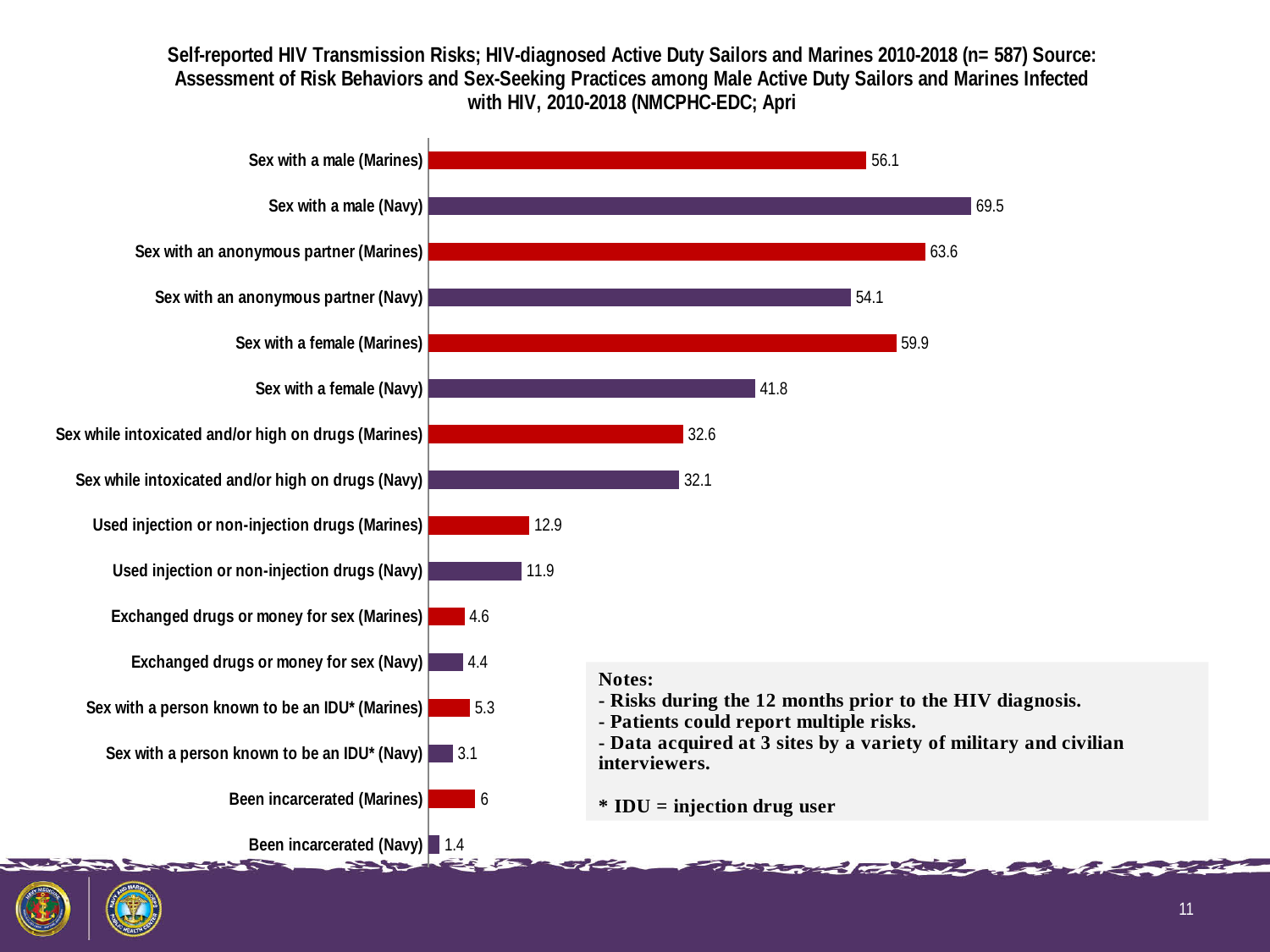
What is the difference between Sex with a male (Navy) and Sex with a male (Marines)? 13.4 What is the value for Sex while intoxicated and/or high on drugs (Navy)? 32.1 Which category has the lowest value? Been incarcerated (Navy) What is the value for Sex with an anonymous partner (Marines)? 63.6 How many bars are plotted in the chart? 16 What is the value for Been incarcerated (Marines)? 6 Which is larger: Sex with an anonymous partner (Marines) or Sex with an anonymous partner (Navy)? Sex with an anonymous partner (Marines) What is the difference between Sex with a female (Marines) and Sex with a female (Navy)? 18.1 What type of chart is shown on the slide? Bar chart Which category has the highest value? Sex with a male (Navy) What is the value for Sex with a male (Navy)? 69.5 What colour are the bars for the Navy categories? Purple